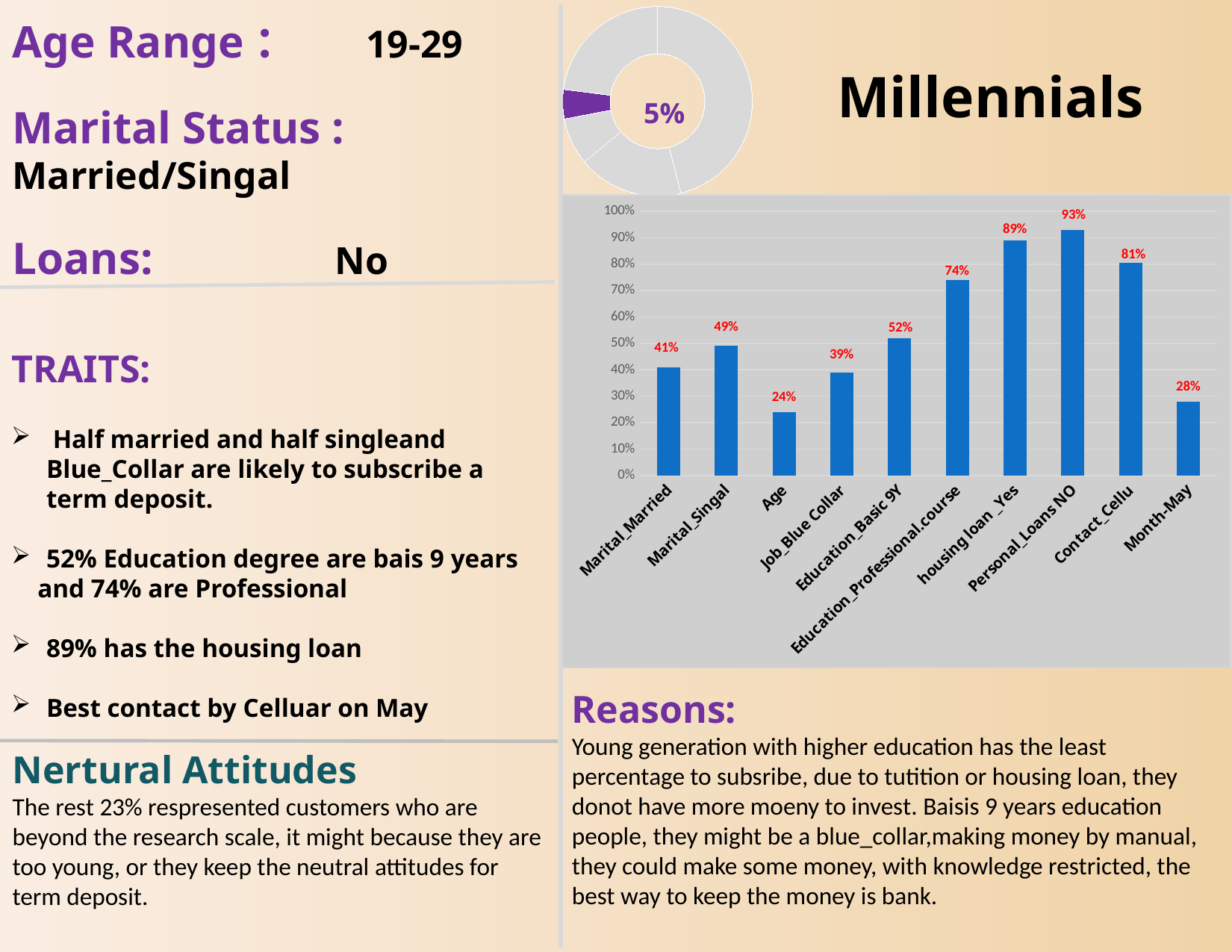
In the bar chart, what is the value for Personal_Loans NO? 93% What kind of chart is the chart with the category axis labels such as Marital_Married and Month-May? bar chart How many categories are shown in the bar chart? 10 In the bar chart, what is the difference between housing loan_Yes and Job_Blue Collar? 50% In the bar chart, which category has the highest value? Personal_Loans NO In the bar chart, which is larger, Marital_Married or Marital_Singal? Marital_Singal In the donut chart at the top of the slide, what value is printed in the centre for the highlighted purple slice? 5% What colour are the bars in the bar chart? blue In the bar chart, what is the value for Education_Basic 9Y? 52% In the bar chart, is the value for Contact_Cellu greater or less than 70%? greater In the bar chart, what is the value for Month-May? 28% In the bar chart, which category has the lowest value? Age